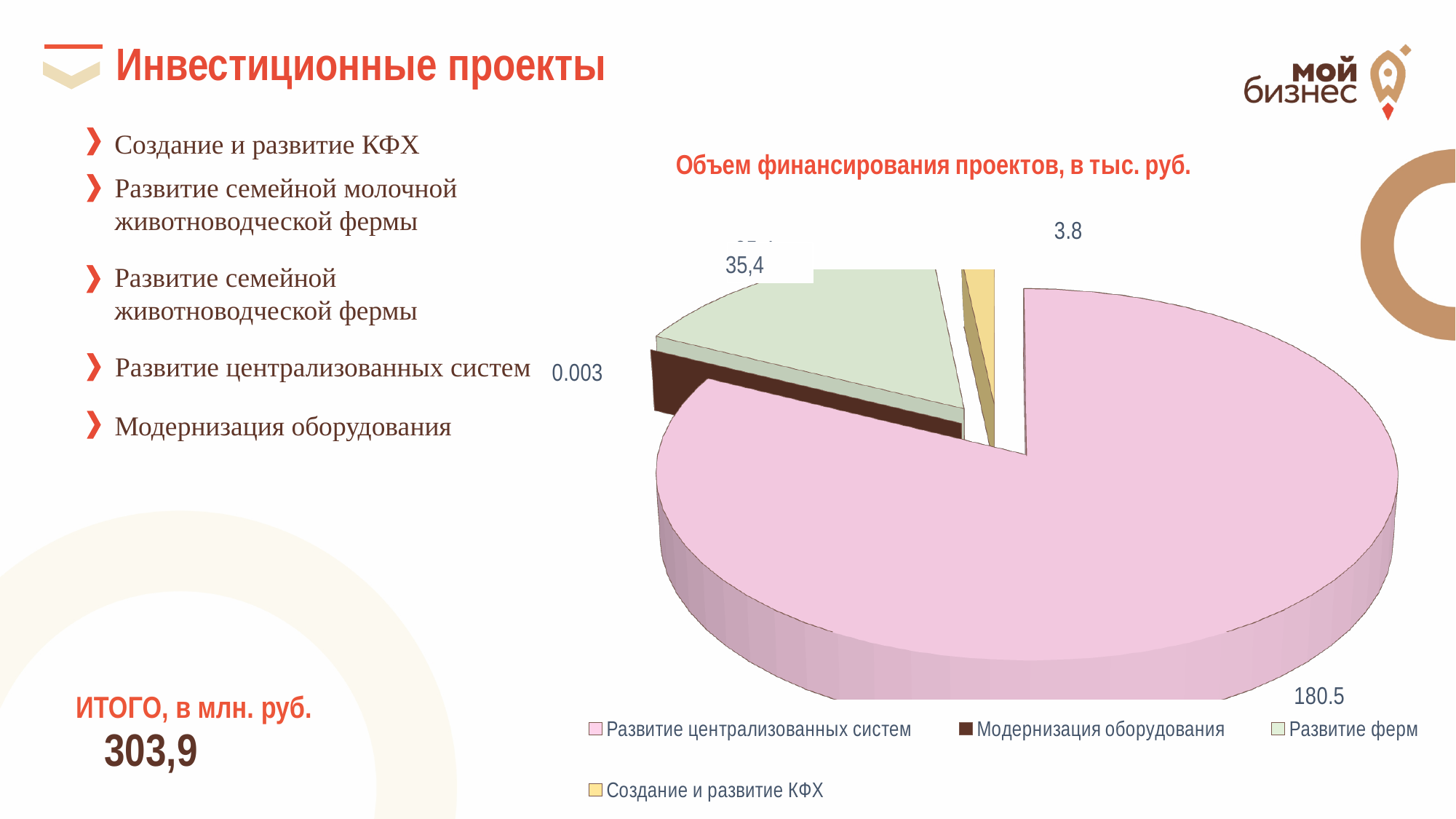
What is the value for Модернизация оборудования? 0.003 Which category has the largest slice of the pie? Развитие централизованных систем Which is larger, Развитие ферм or Создание и развитие КФХ? Развитие ферм How many slices does the pie chart have? 4 Which category has the smallest slice of the pie? Модернизация оборудования What kind of chart is shown on the slide? pie chart How many entries does the chart legend list? 4 What is the title of the chart? Объем финансирования проектов, в тыс. руб. What is the value for Развитие централизованных систем? 180.5 What is the value for Создание и развитие КФХ? 3.8 What is the difference between the values for Развитие централизованных систем and Создание и развитие КФХ? 176.7 What is the value for Развитие ферм? 35,4